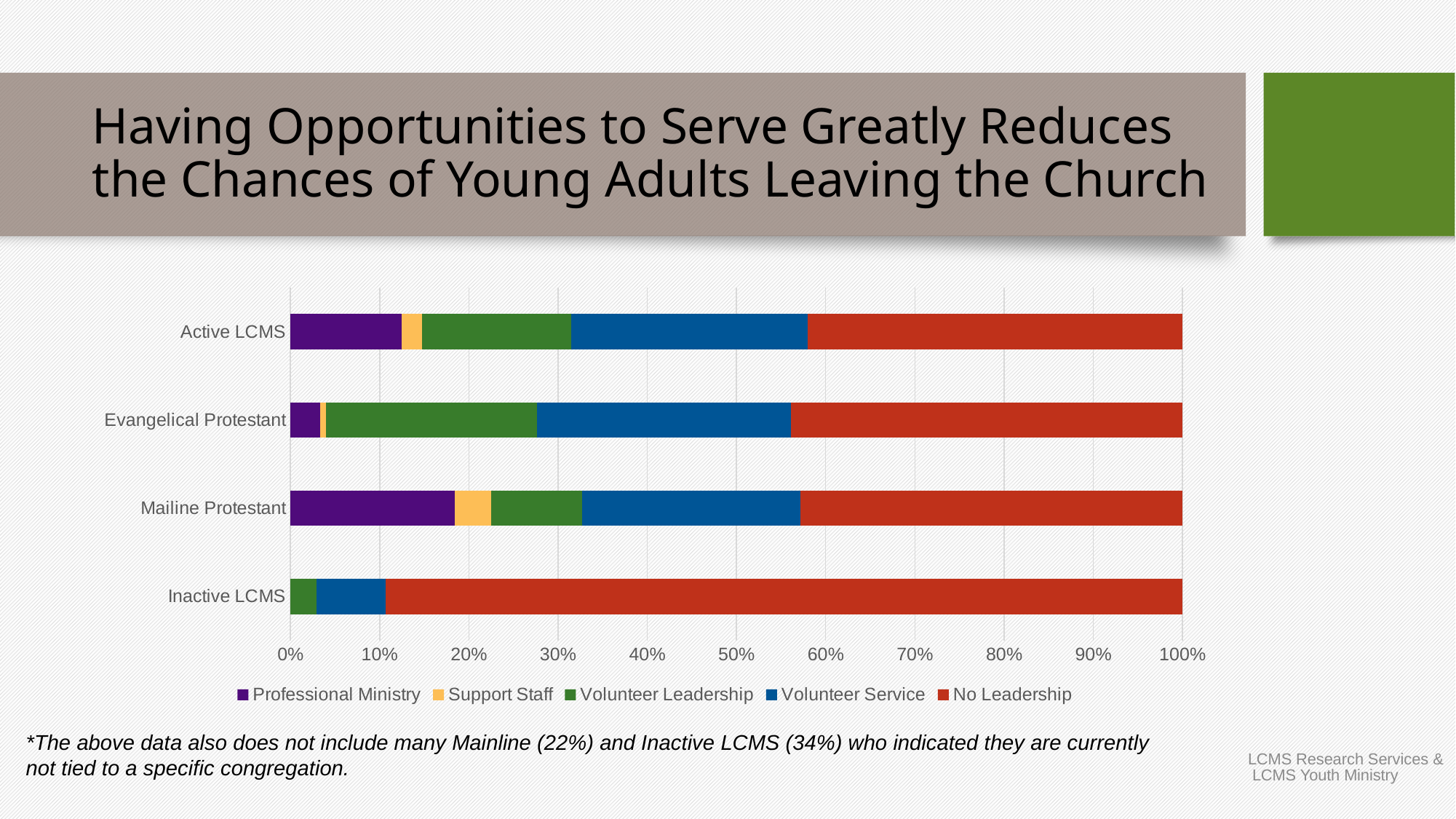
What is the total of the Active LCMS stacked bar? 100% Which is larger for Active LCMS: the Volunteer Service segment or the Support Staff segment? Volunteer Service What kind of chart is shown on the slide? stacked bar chart How many series does the chart legend list? 5 Which category has the smallest Volunteer Service segment? Inactive LCMS Is the Professional Ministry share for Active LCMS greater or less than 10%? greater How many categories (groups) are plotted on the chart? 4 Which category has the largest No Leadership segment? Inactive LCMS Is the No Leadership share for Inactive LCMS greater or less than 80%? greater Which category has the largest Professional Ministry segment? Mailine Protestant Is the Volunteer Leadership share for Evangelical Protestant greater or less than 20%? greater What colour represents No Leadership in the legend? red